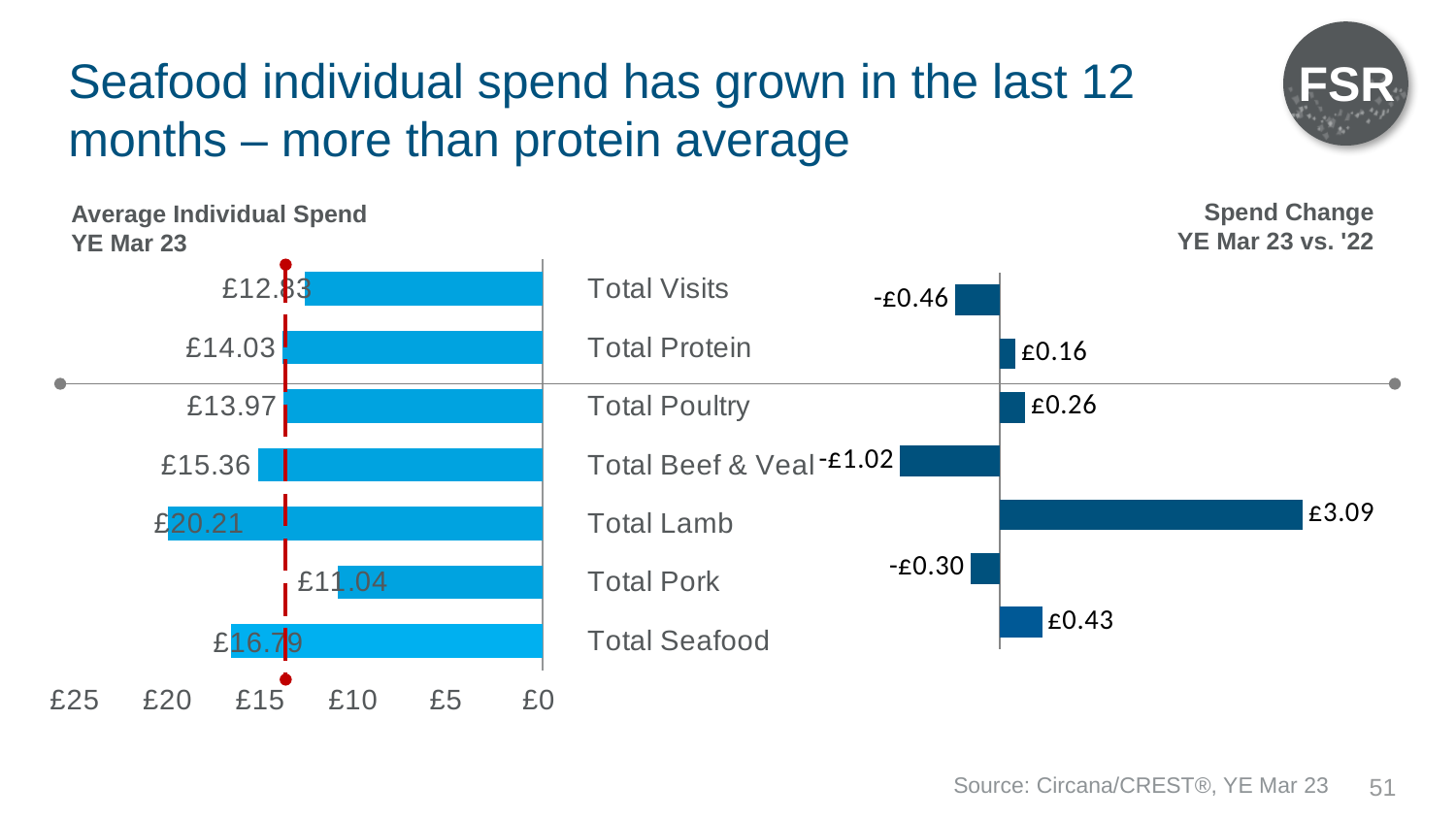
In the Spend Change YE Mar 23 vs. '22 chart, which category has the highest value? Total Lamb How many categories are shown in the Spend Change YE Mar 23 vs. '22 chart? 7 In the Average Individual Spend YE Mar 23 chart, which category has the lowest value? Total Pork In the Average Individual Spend YE Mar 23 chart, what is the difference between Total Lamb and Total Pork? £9.17 In the Spend Change YE Mar 23 vs. '22 chart, what is the difference between Total Seafood and Total Protein? £0.27 In the Spend Change YE Mar 23 vs. '22 chart, which category has the lowest value? Total Beef & Veal In the Spend Change YE Mar 23 vs. '22 chart, what is the value for Total Lamb? £3.09 In the Average Individual Spend YE Mar 23 chart, which is larger: Total Beef & Veal or Total Protein? Total Beef & Veal In the Average Individual Spend YE Mar 23 chart, what is the value for Total Lamb? £20.21 In the Spend Change YE Mar 23 vs. '22 chart, what is the value for Total Beef & Veal? -£1.02 In the Spend Change YE Mar 23 vs. '22 chart, what is the value for Total Seafood? £0.43 In the Average Individual Spend YE Mar 23 chart, what is the value for Total Poultry? £13.97